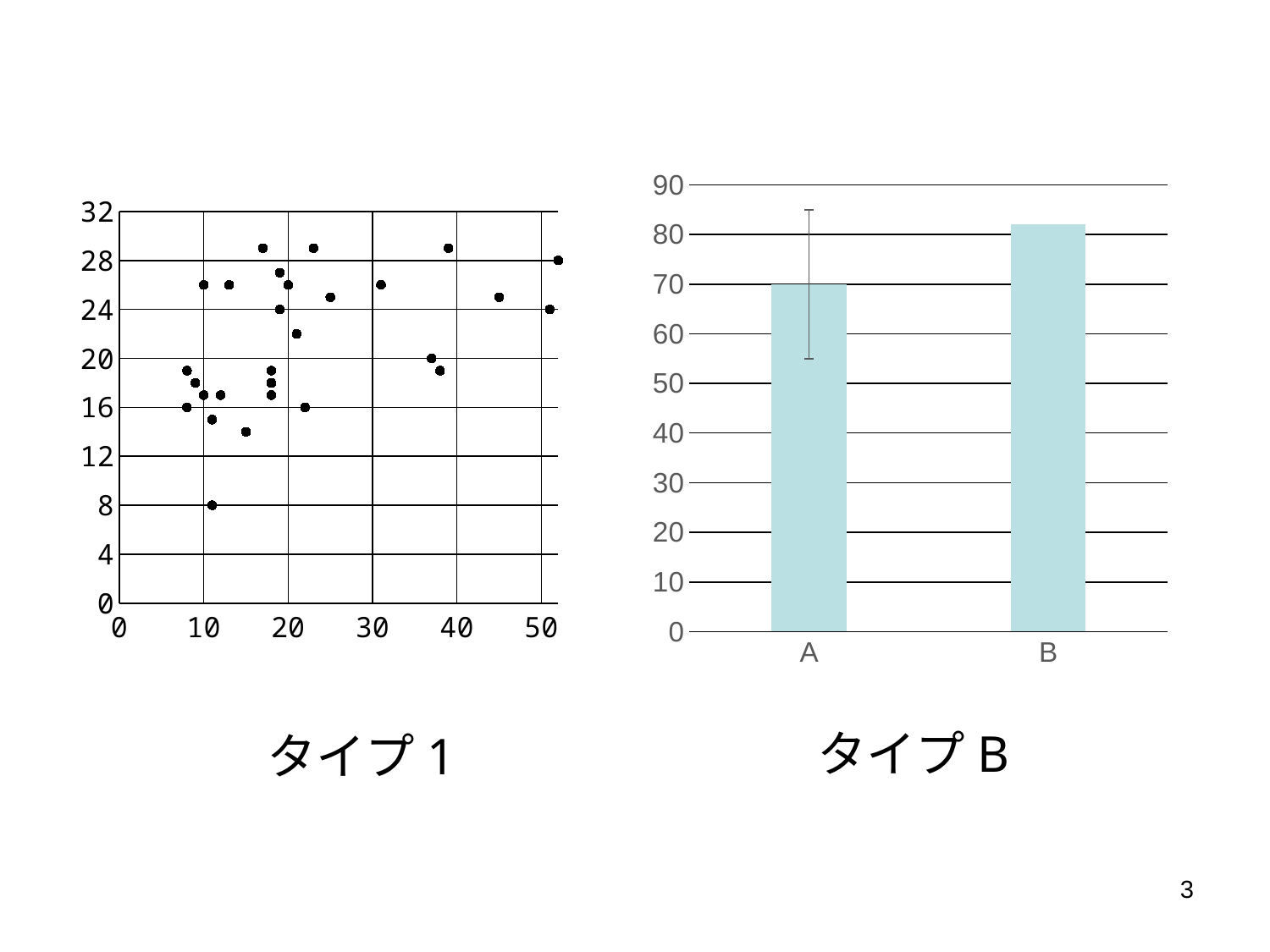
In the right-hand chart (タイプB), which category has the lower bar? A In the right-hand chart (タイプB), what is the value of bar A? 70 In the right-hand chart (タイプB), which category has the higher bar? B In the right-hand chart (タイプB), is the value for B greater or less than 90? less In the left-hand chart (タイプ1), what is the y value of the lowest point? 8 In the left-hand chart (タイプ1), what is the highest value shown on the y axis? 32 What kind of chart is the left-hand chart (タイプ1)? scatter plot In the right-hand chart (タイプB), how many categories are shown on the x axis? 2 What kind of chart is the right-hand chart (タイプB)? bar chart In the right-hand chart (タイプB), is the value for B greater or less than 80? greater In the right-hand chart (タイプB), which bar has an error bar drawn on it? A